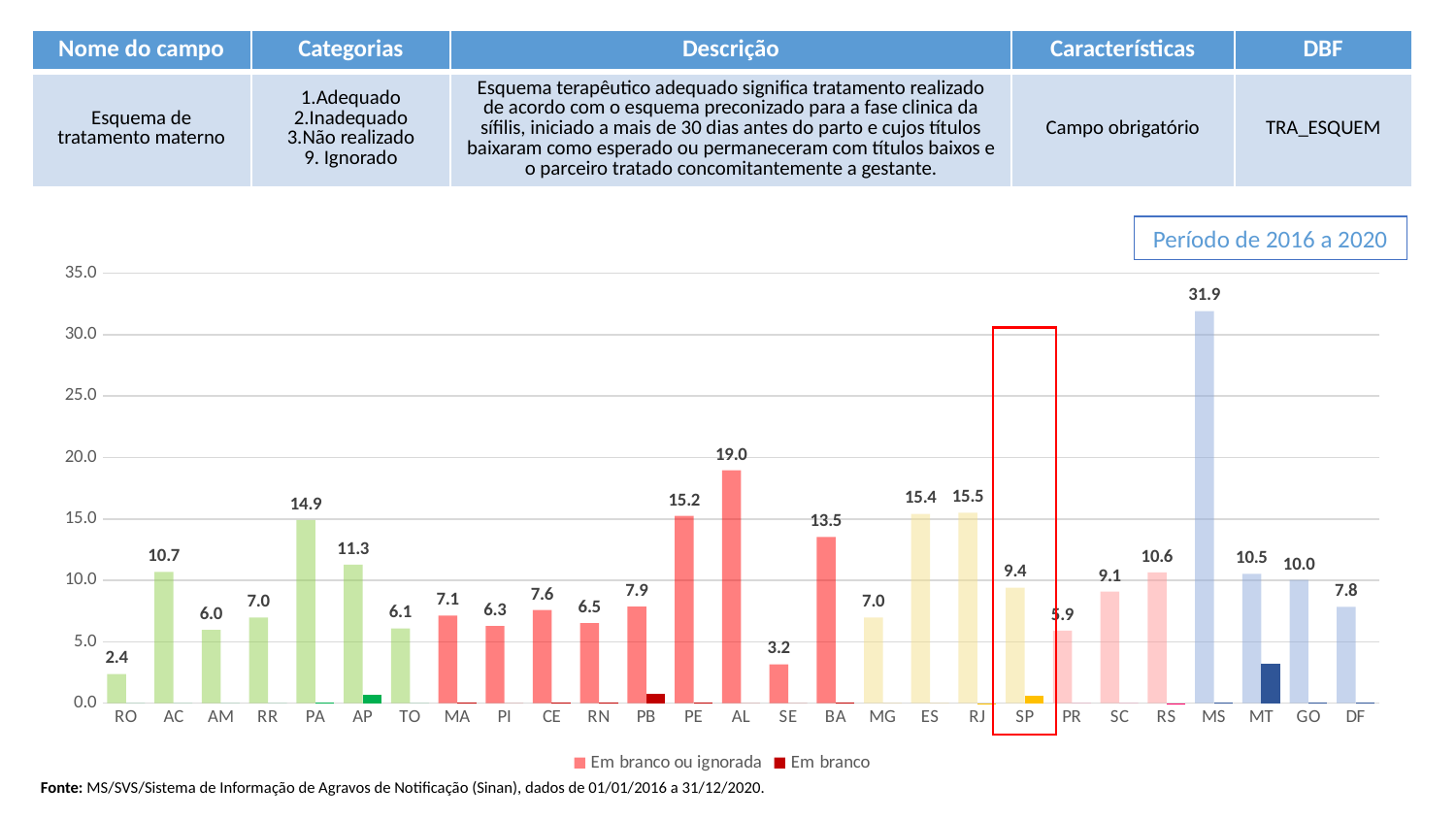
Which state has the lowest value for "Em branco ou ignorada"? RO What is the value of "Em branco ou ignorada" for SP? 9.4 Is the "Em branco ou ignorada" value for PA greater or less than 10.0? greater What is the value of "Em branco ou ignorada" for MS? 31.9 How many series does the legend list? 2 How many states are shown on the x axis of the chart? 27 Which state has the highest value for "Em branco ou ignorada"? MS What period does the chart cover, according to the box above it? Período de 2016 a 2020 What type of chart is shown on the slide? Bar chart What is the value of "Em branco ou ignorada" for AL? 19.0 Which has a larger "Em branco ou ignorada" value, PE or BA? PE What is the difference between the "Em branco ou ignorada" values for MS and AL? 12.9